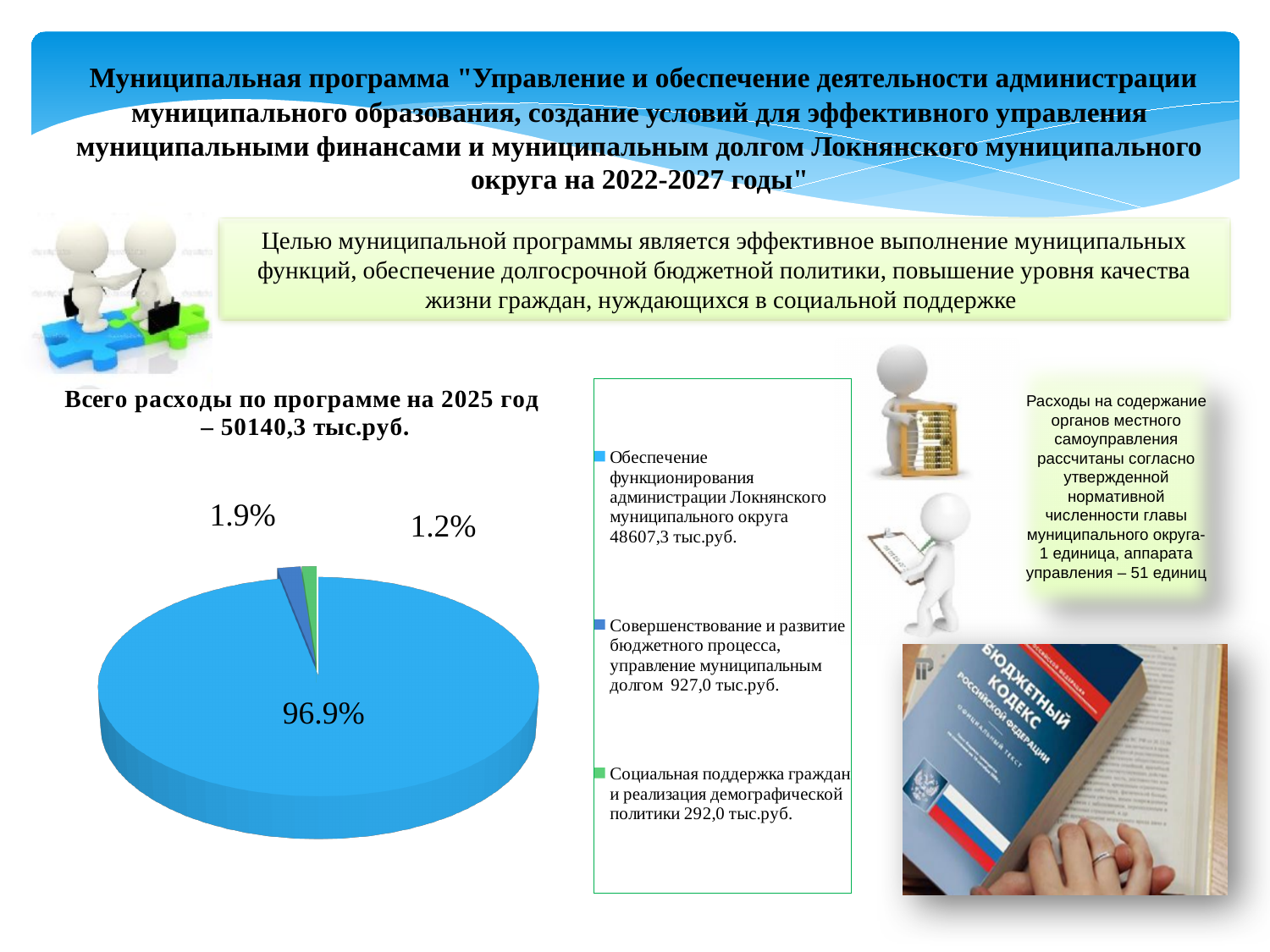
What colour is the largest slice of the pie chart? light blue What kind of chart is shown on the slide? pie chart Which category has the largest share of the pie chart? Обеспечение функционирования администрации Локнянского муниципального округа According to the legend, what is the amount for 'Совершенствование и развитие бюджетного процесса, управление муниципальным долгом'? 927,0 тыс.руб. What share of the pie chart does 'Совершенствование и развитие бюджетного процесса, управление муниципальным долгом' take? 1.9% How many entries does the legend of the pie chart list? 3 What is the difference in percentage points between the largest slice (96.9%) and the 1.9% slice? 95.0 According to the legend, what is the amount for 'Социальная поддержка граждан и реализация демографической политики'? 292,0 тыс.руб. What share of the pie chart does 'Обеспечение функционирования администрации Локнянского муниципального округа' take? 96.9% Which category has the smallest share of the pie chart? Социальная поддержка граждан и реализация демографической политики What share of the pie chart does 'Социальная поддержка граждан и реализация демографической политики' take? 1.2% How many slices does the pie chart have? 3